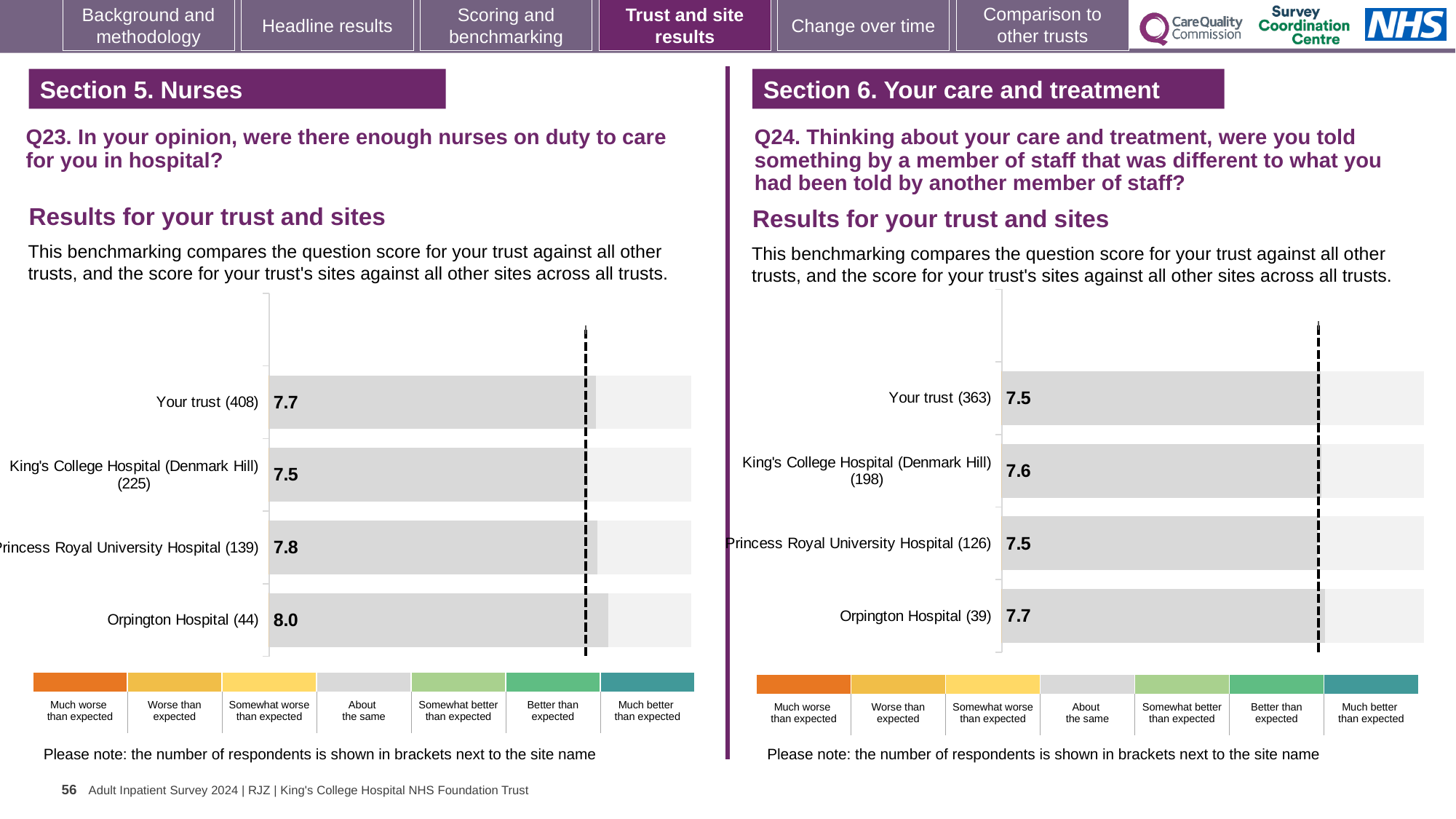
In the Q23 chart on the left, what is the score for Orpington Hospital? 8.0 In the Q24 chart on the right, which is larger: the score for Orpington Hospital or the score for Your trust? Orpington Hospital In the Q23 chart on the left, what is the difference between the scores for Orpington Hospital and King's College Hospital (Denmark Hill)? 0.5 In the Q23 chart on the left, how many respondents are shown in brackets for Your trust? 408 In the Q23 chart on the left, what is the score for Your trust? 7.7 In the Q23 chart on the left, how many bars are plotted? 4 In the Q23 chart on the left, which site has the highest score? Orpington Hospital In the Q24 chart on the right, what is the score for Princess Royal University Hospital? 7.5 What kind of chart is used in the Q24 chart on the right? Bar chart In the Q24 chart on the right, what is the score for King's College Hospital (Denmark Hill)? 7.6 In the Q23 chart on the left, which bar has the lowest score? King's College Hospital (Denmark Hill) In the Q24 chart on the right, which site has the highest score? Orpington Hospital